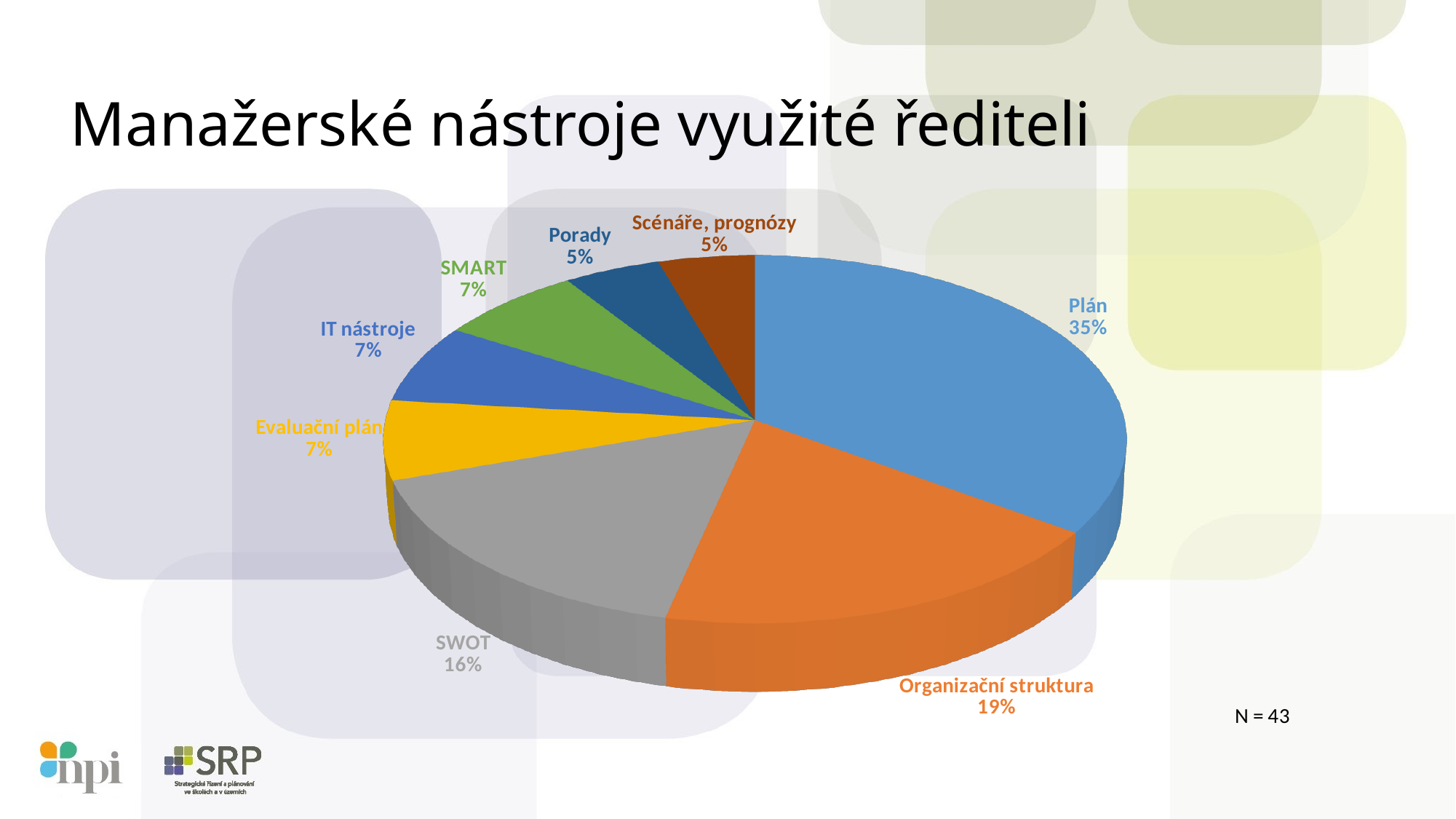
Which category has the largest slice of the pie? Plán What is the value shown for Porady? 5% What is the difference in percentage points between Plán and Organizační struktura? 16 What is the difference in percentage points between SWOT and Evaluační plán? 9 What is the title of the chart on the slide? Manažerské nástroje využité řediteli Which is larger, the slice for SWOT or the slice for SMART? SWOT What sample size (N) is stated on the slide? N = 43 What is the value shown for SWOT? 16% What kind of chart is shown on the slide? pie chart How many slices does the pie chart have? 8 What is the value shown for Organizační struktura? 19% What share of the pie does Plán have? 35%